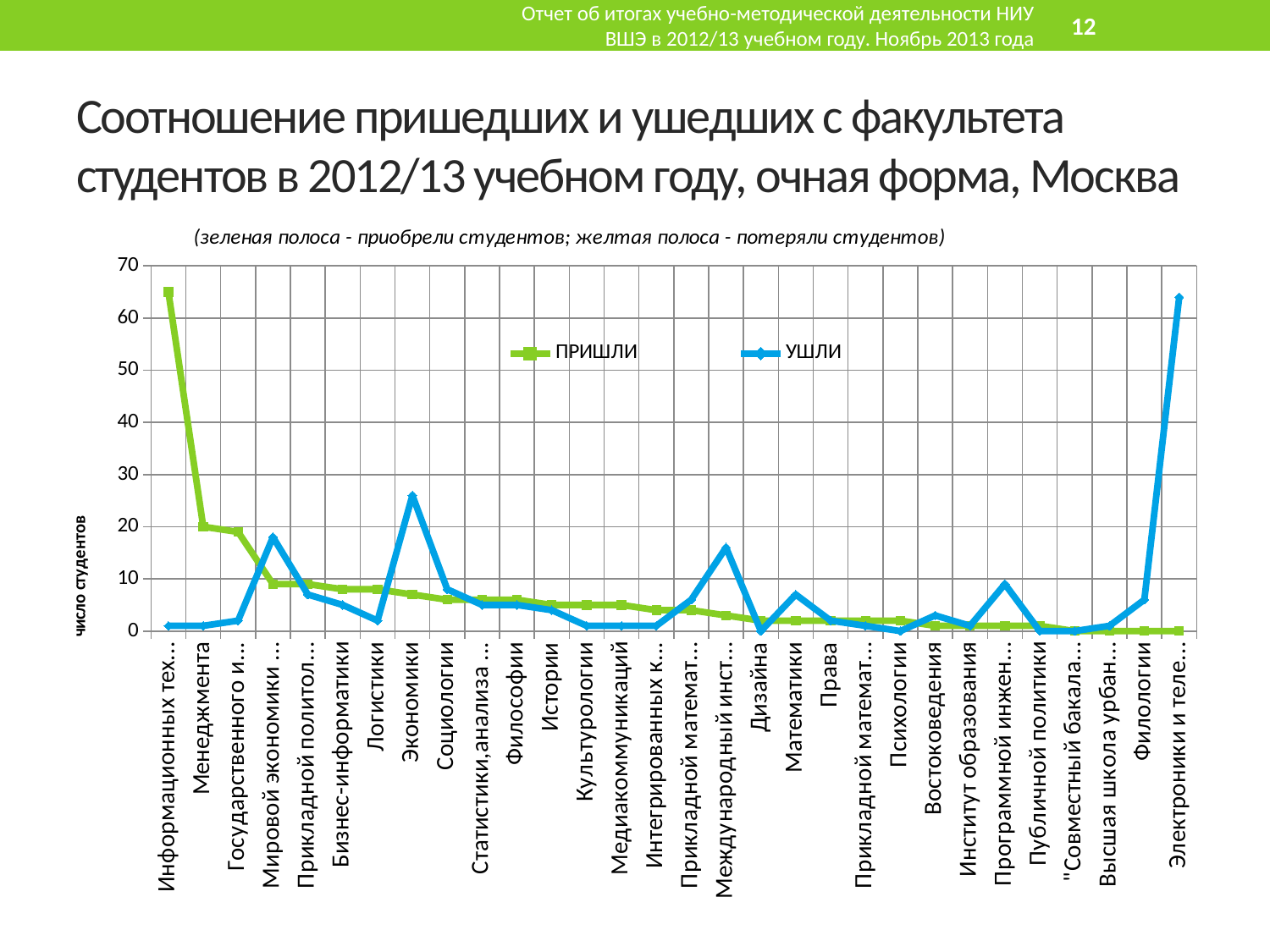
Which category has the highest value for the УШЛИ series? Электроники и теле... Does the ПРИШЛИ series generally rise or fall from left to right along the x axis? fall Which category has the highest value for the ПРИШЛИ series? Информационных тех... How many faculty categories are plotted along the x axis? 30 What colour is the ПРИШЛИ series line? green Is the УШЛИ value for Международный инст... greater or less than 10? greater For Экономики, which series has the larger value, ПРИШЛИ or УШЛИ? УШЛИ What kind of chart is shown on the slide? line chart Is the ПРИШЛИ value for Менеджмента greater or less than 30? less How many series does the legend list? 2 Is the ПРИШЛИ value for Информационных тех... greater or less than 60? greater